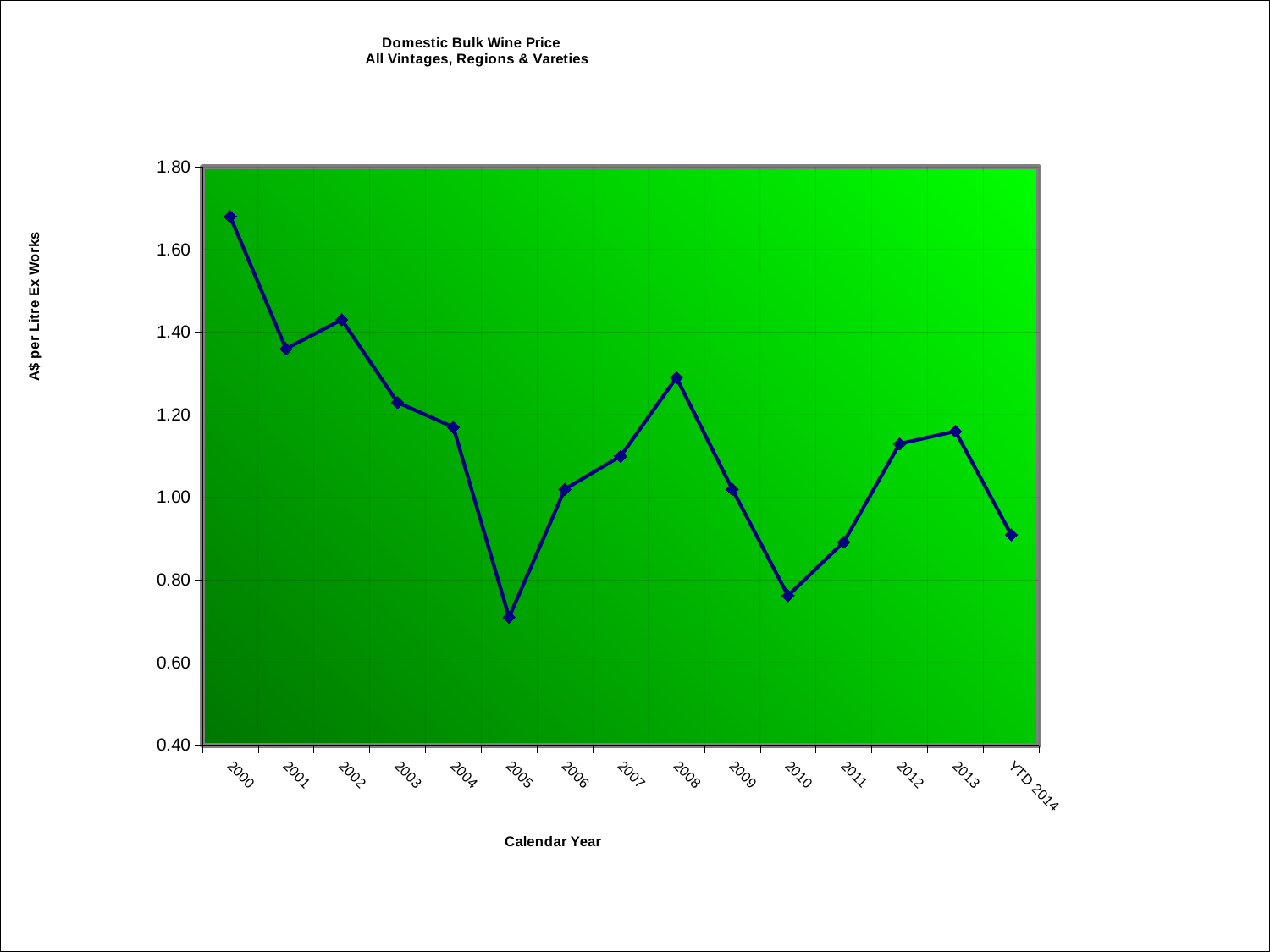
Is the value for 2010 greater or less than 0.80? less Which year has the highest domestic bulk wine price? 2000 Overall, does the price rise or fall from 2000 to YTD 2014? fall Is the value for 2000 greater or less than 1.60? greater Is the value for 2008 greater or less than 1.20? greater Which year has the lowest domestic bulk wine price? 2005 What kind of chart is shown on the slide? line chart Which is larger, the value for 2008 or the value for 2009? 2008 What is the label on the vertical axis of the chart? A$ per Litre Ex Works Which is larger, the value for 2000 or the value for 2001? 2000 How many data points are plotted on the chart? 15